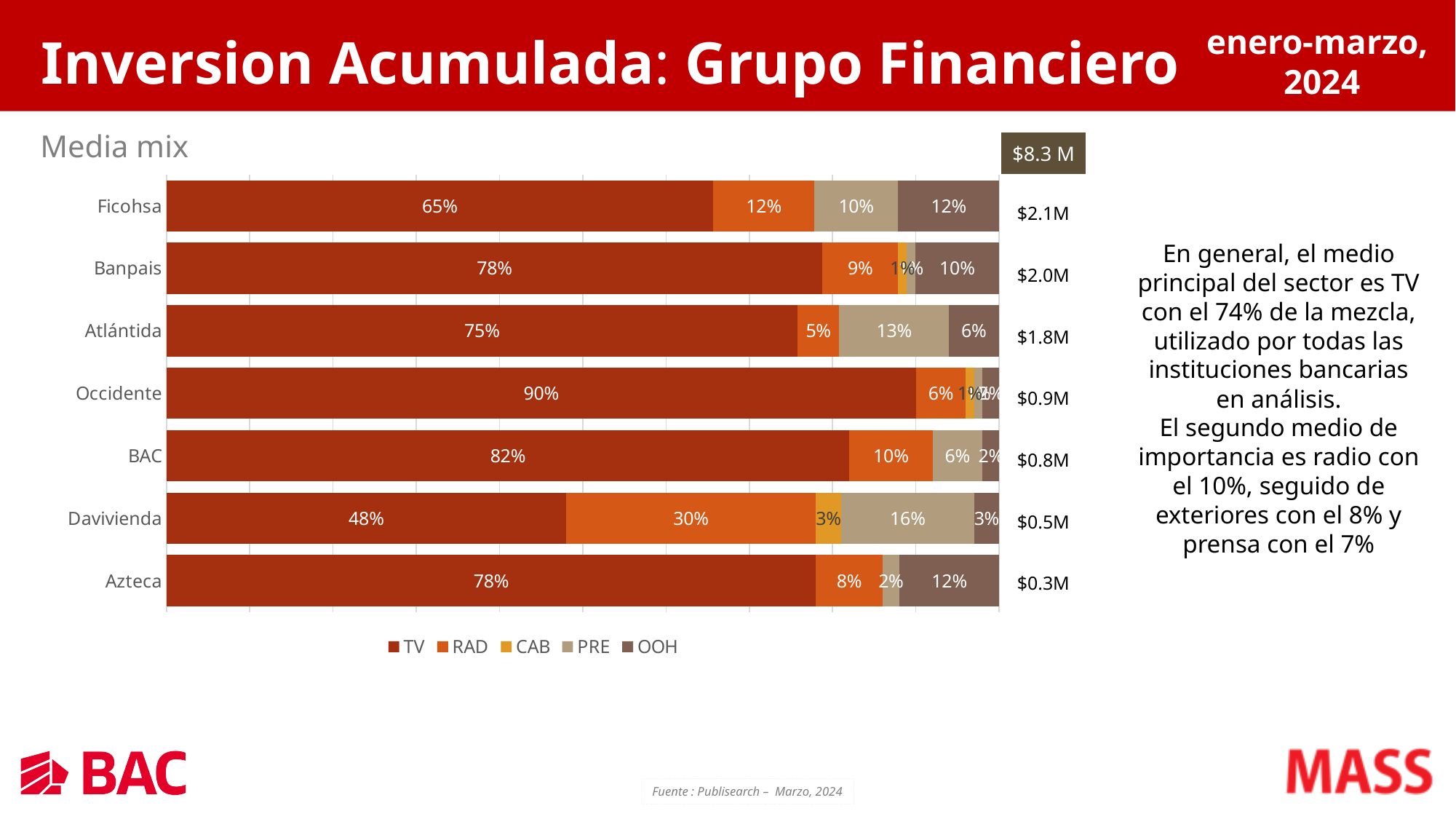
In the Media mix chart, which has a larger OOH share, Ficohsa or Atlántida? Ficohsa In the Media mix chart, what percentage of Ficohsa's media mix is TV? 65% In the Media mix chart, what is the RAD share for Davivienda? 30% How many banks are shown in the Media mix chart? 7 In the Media mix chart, which bank has the highest TV share? Occidente In the Media mix chart, which bank has the lowest TV share? Davivienda In the Media mix chart, what is the PRE share for Atlántida? 13% How many series does the legend of the Media mix chart list? 5 In the Media mix chart, what is the OOH share for Azteca? 12% What total investment amount is shown next to the Ficohsa bar in the Media mix chart? $2.1M What kind of chart is the Media mix chart? Stacked bar chart In the Media mix chart, how many percentage points higher is Banpais's TV share than Ficohsa's TV share? 13 percentage points